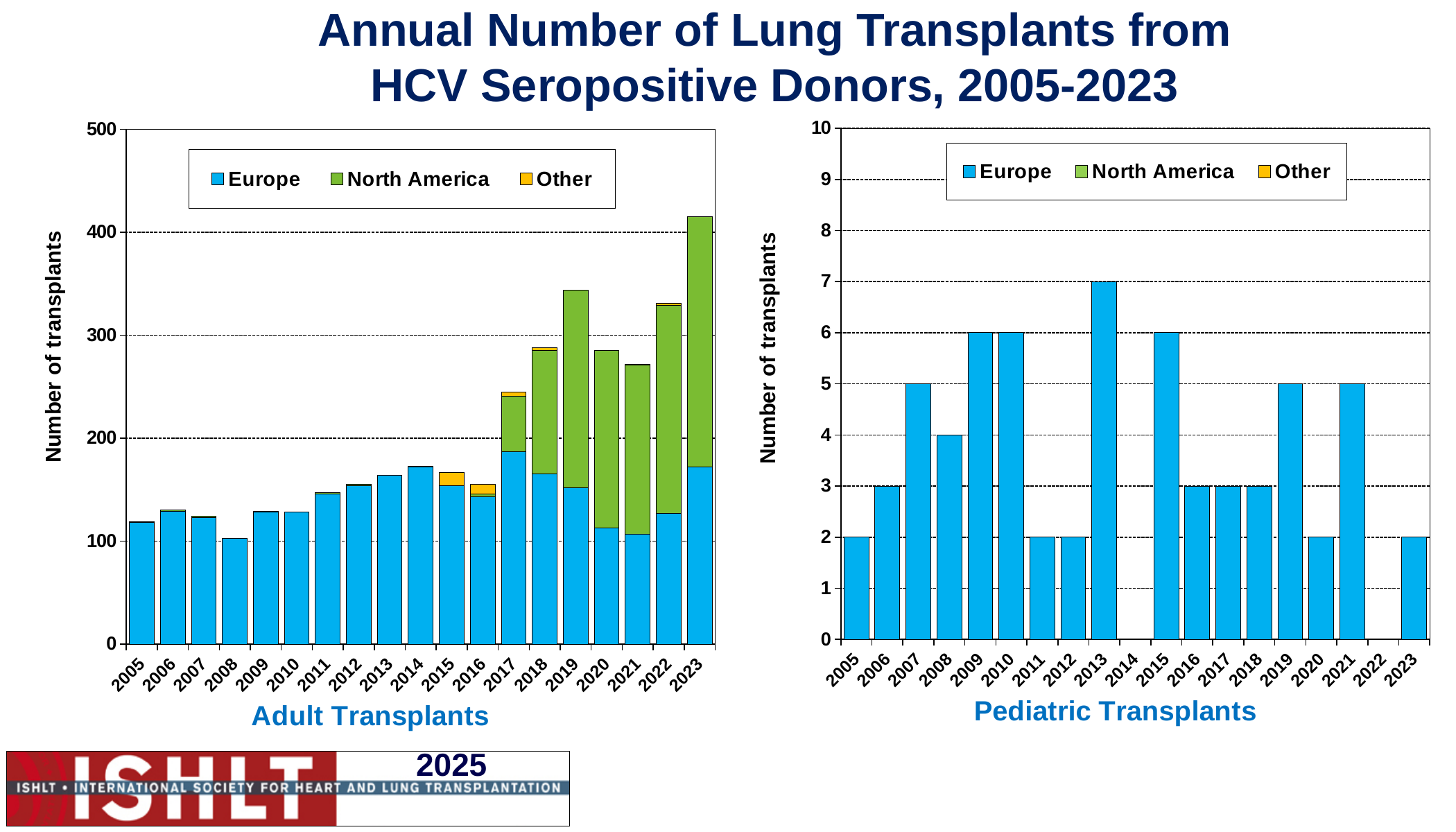
In the Pediatric Transplants chart, which year has the larger value, 2009 or 2016? 2009 How many years are shown on the x axis of the Pediatric Transplants chart? 19 In the Pediatric Transplants chart, what is the difference between the 2013 value and the 2005 value? 5 What type of chart is the Adult Transplants chart? stacked bar chart In the Adult Transplants chart, is the total value for 2013 greater or less than 200? less In the Adult Transplants chart, which year has the highest total number of transplants? 2023 How many series does the legend of the Adult Transplants chart list? 3 In the Pediatric Transplants chart, what is the number of transplants in 2013? 7 In the Adult Transplants chart, which series is shown in green? North America In the Adult Transplants chart, is the total value for 2023 greater or less than 400? greater In the Pediatric Transplants chart, which year has the highest number of transplants? 2013 In the Pediatric Transplants chart, what is the number of transplants in 2008? 4